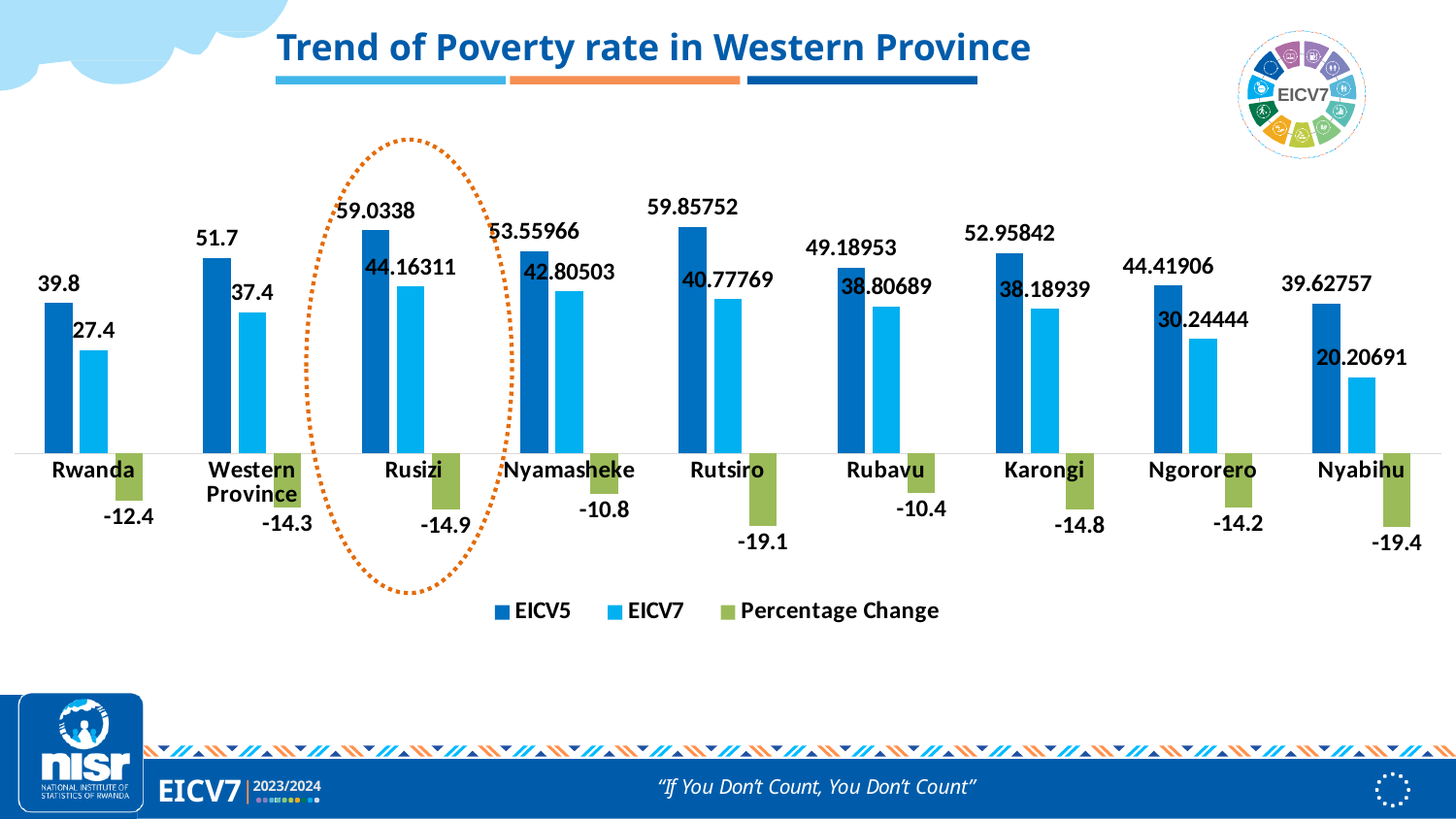
Which category has the lowest EICV7 value? Nyabihu How many series does the legend list? 3 What is the EICV7 poverty rate for Nyabihu? 20.20691 What is the Percentage Change value for Rutsiro? -19.1 What kind of chart is shown on the slide? Bar chart Which category has the smallest Percentage Change in magnitude (closest to zero)? Rubavu Which is larger, the EICV7 value for Nyamasheke or the EICV7 value for Rubavu? Nyamasheke How many categories are shown on the x axis? 9 What is the difference between the EICV5 and EICV7 values for Rwanda? 12.4 Which category has the highest EICV5 value? Rutsiro What is the EICV5 poverty rate for Rusizi? 59.0338 Which category is highlighted with a dotted orange circle? Rusizi